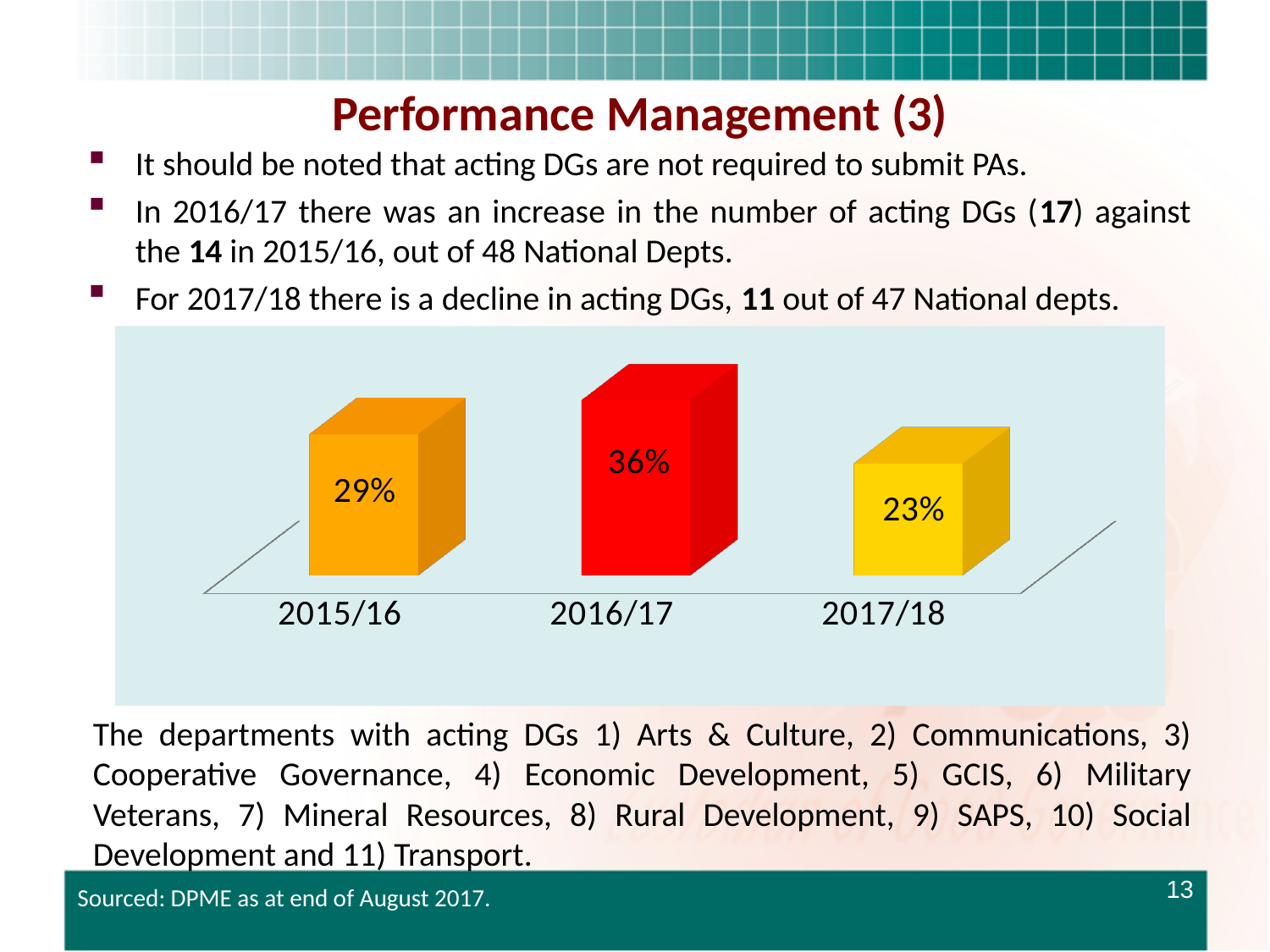
What is the value shown for 2017/18? 23% Which year has the highest value? 2016/17 What kind of chart is shown on the slide? bar chart What colour is the bar for 2016/17? red How many years are shown on the chart? 3 What is the difference between the values for 2016/17 and 2015/16? 7% What is the difference between the values for 2016/17 and 2017/18? 13% Which year has the lowest value? 2017/18 Which is larger, the value for 2015/16 or the value for 2017/18? 2015/16 Does the value rise or fall from 2016/17 to 2017/18? fall What is the value shown for 2015/16? 29% What is the value shown for 2016/17? 36%